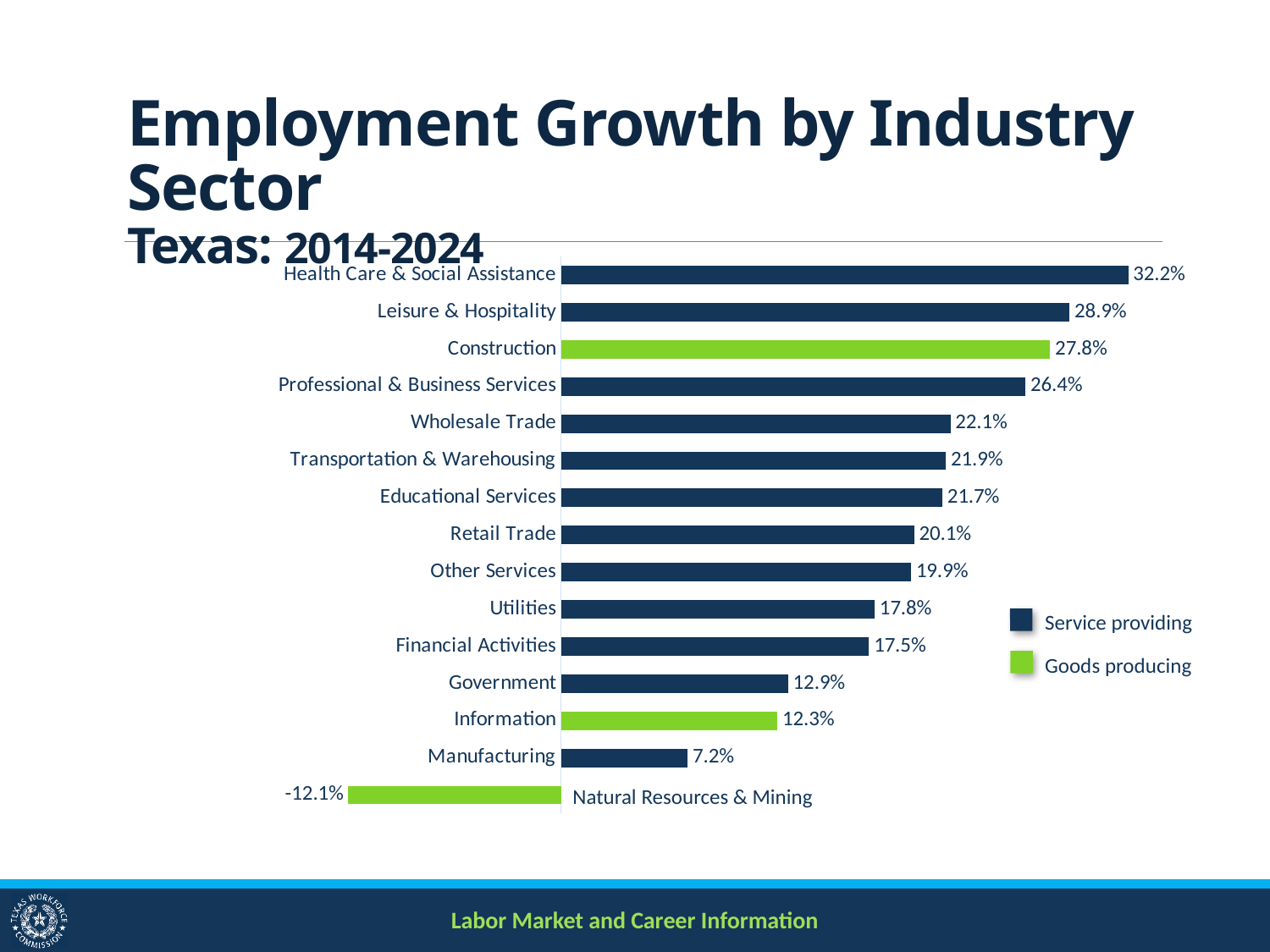
How many series does the legend list? 2 What kind of chart is shown on the slide? Bar chart What is the difference between the employment growth for Leisure & Hospitality and Government? 16.0% How many industry sectors are shown in the chart? 15 What is the employment growth value for Construction? 27.8% Which industry sector has the lowest employment growth? Natural Resources & Mining Which has higher employment growth, Wholesale Trade or Retail Trade? Wholesale Trade Which legend entry is shown in green? Goods producing What is the employment growth value for Natural Resources & Mining? -12.1% What is the employment growth value for Manufacturing? 7.2% What is the employment growth value for Health Care & Social Assistance? 32.2% Which industry sector has the highest employment growth? Health Care & Social Assistance